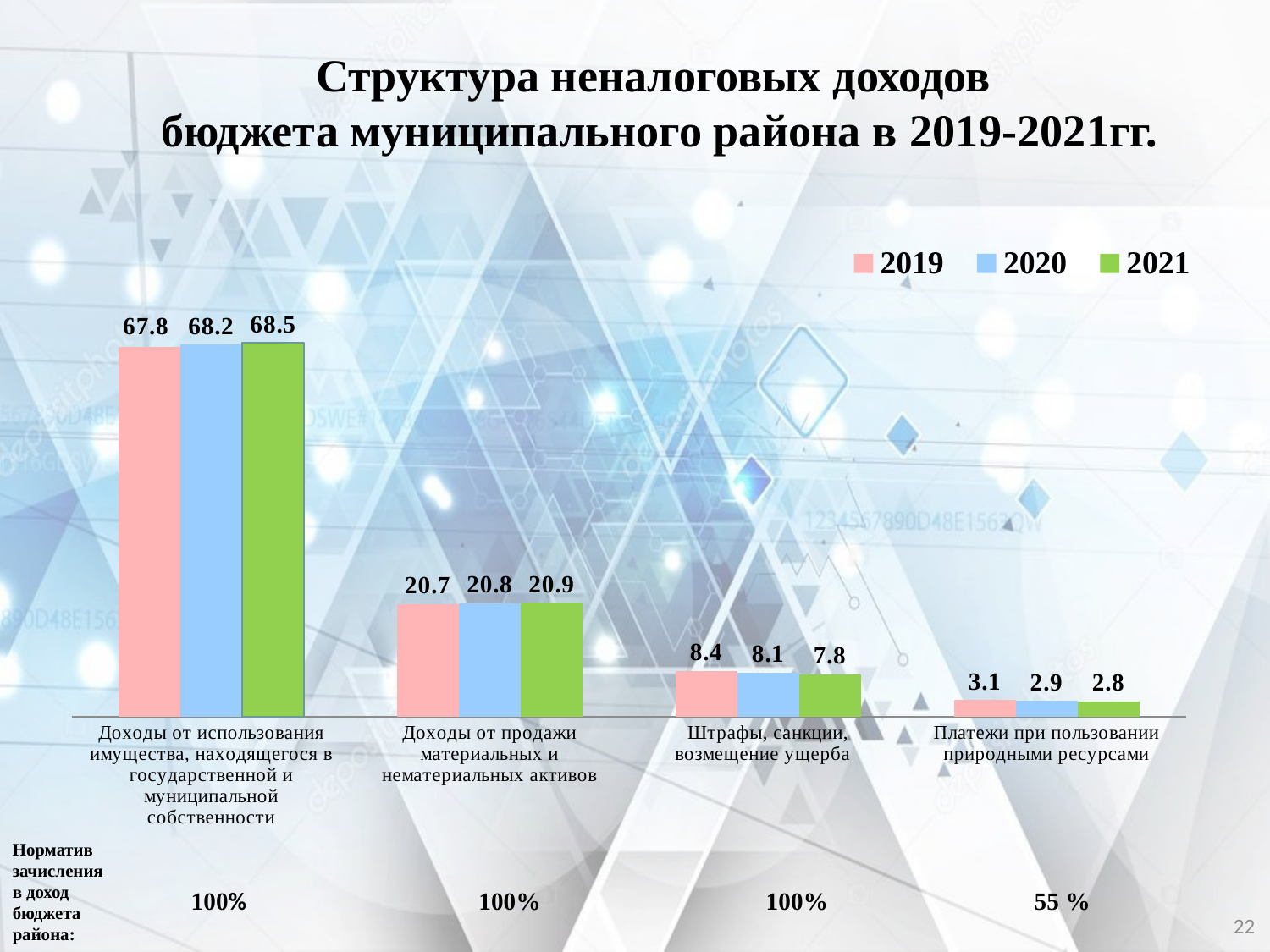
Which is larger: the 2019 value for "Штрафы, санкции, возмещение ущерба" or the 2021 value for the same category? 2019 (8.4) Do the values for "Штрафы, санкции, возмещение ущерба" rise or fall from 2019 to 2021? Fall Which category has the highest value in 2021? Доходы от использования имущества, находящегося в государственной и муниципальной собственности How many categories are shown on the x axis of the chart? 4 What is the 2021 value for "Доходы от продажи материальных и нематериальных активов"? 20.9 What is the difference between the 2021 and 2019 values for "Доходы от использования имущества, находящегося в государственной и муниципальной собственности"? 0.7 What is the 2020 value for "Платежи при пользовании природными ресурсами"? 2.9 What kind of chart is shown on the slide? Bar chart What is the 2019 value for "Штрафы, санкции, возмещение ущерба"? 8.4 Which category has the lowest value in 2019? Платежи при пользовании природными ресурсами How many series does the legend list? 3 Which colour represents the 2020 series in the legend? Blue